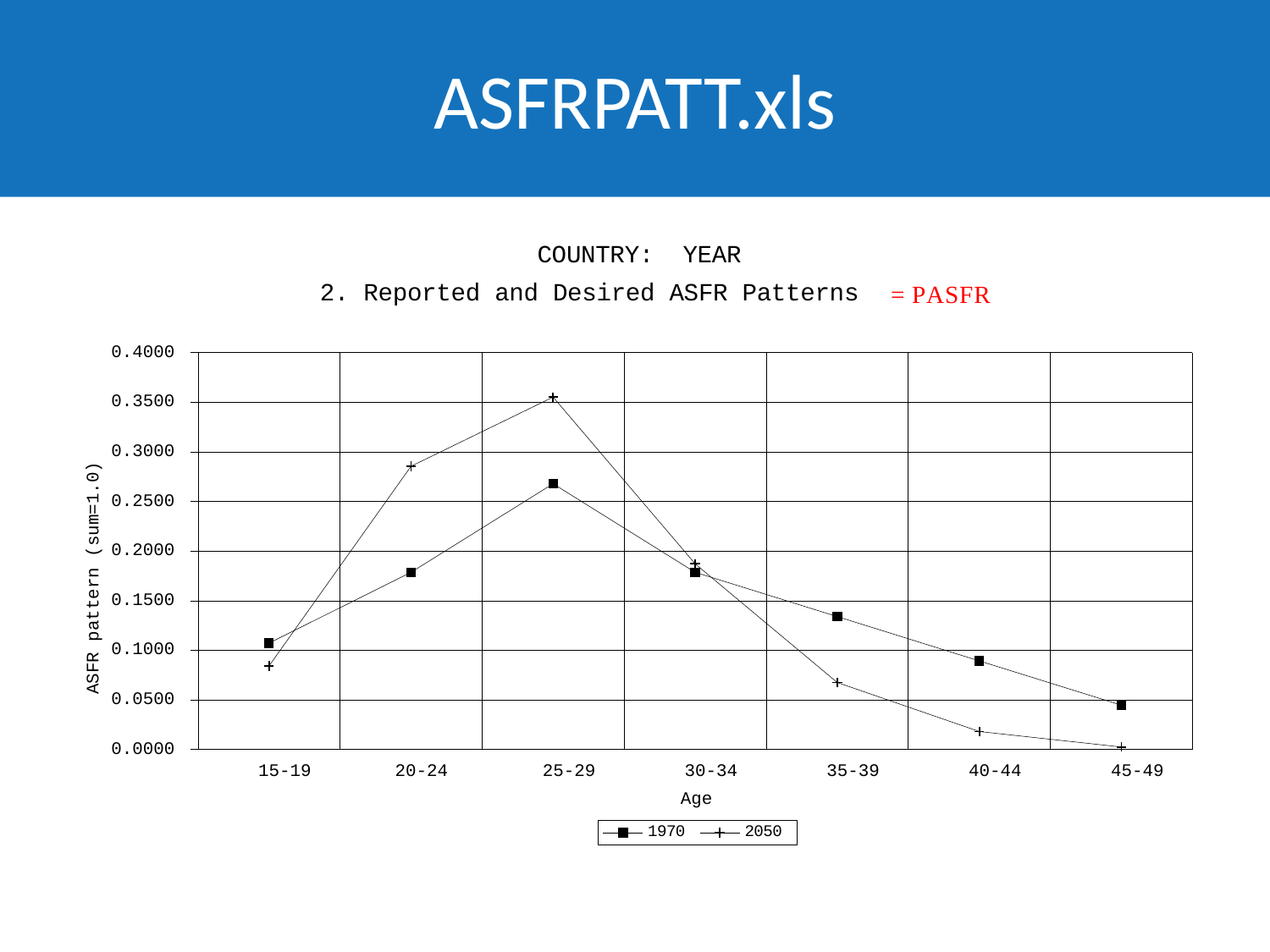
Do the 1970 values rise or fall from age group 25-29 to 45-49? fall How many age groups are plotted along the x axis? 7 For the 2050 series, which age group has the lowest value? 45-49 At age group 35-39, which series has the larger value, 1970 or 2050? 1970 What are the two entries in the chart legend? 1970 and 2050 Is the 1970 value for age group 40-44 greater or less than 0.1000? less At age group 20-24, which series has the larger value, 1970 or 2050? 2050 How many series does the chart legend list? 2 What kind of chart is shown on the slide? line chart For the 1970 series, which age group has the highest value? 25-29 For the 2050 series, which age group has the highest value? 25-29 Is the 2050 value for age group 25-29 greater or less than 0.3000? greater